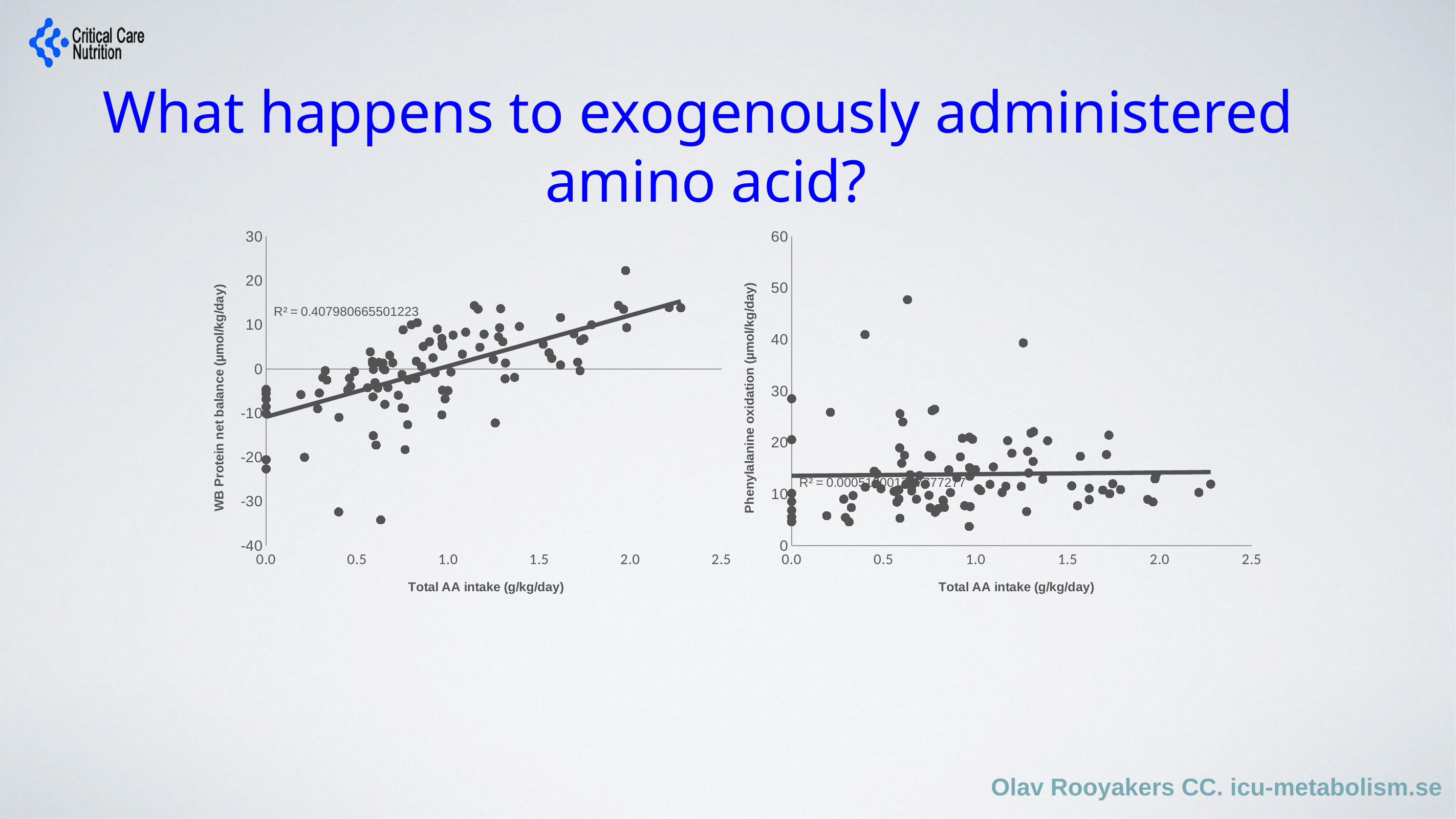
What R² value is printed on the left chart (WB Protein net balance)? 0.407980665501223 What is the x-axis label of the left chart (WB Protein net balance)? Total AA intake (g/kg/day) How many charts are shown on the slide? 2 In the right chart (Phenylalanine oxidation), is the highest plotted point greater or less than 40? greater In the left chart (WB Protein net balance), does the trend line rise or fall as Total AA intake increases? rises What kind of chart is the right chart, with Phenylalanine oxidation on the y axis? scatter chart What is the y-axis label of the right chart? Phenylalanine oxidation (µmol/kg/day) In the left chart (WB Protein net balance), is the lowest plotted point greater or less than -30? less In the right chart (Phenylalanine oxidation), is the trend line greater or less than 20 at a Total AA intake of 1.0? less In the right chart (Phenylalanine oxidation), does the trend line rise, fall, or stay roughly flat as Total AA intake increases? roughly flat What kind of chart is the left chart, with WB Protein net balance on the y axis? scatter chart